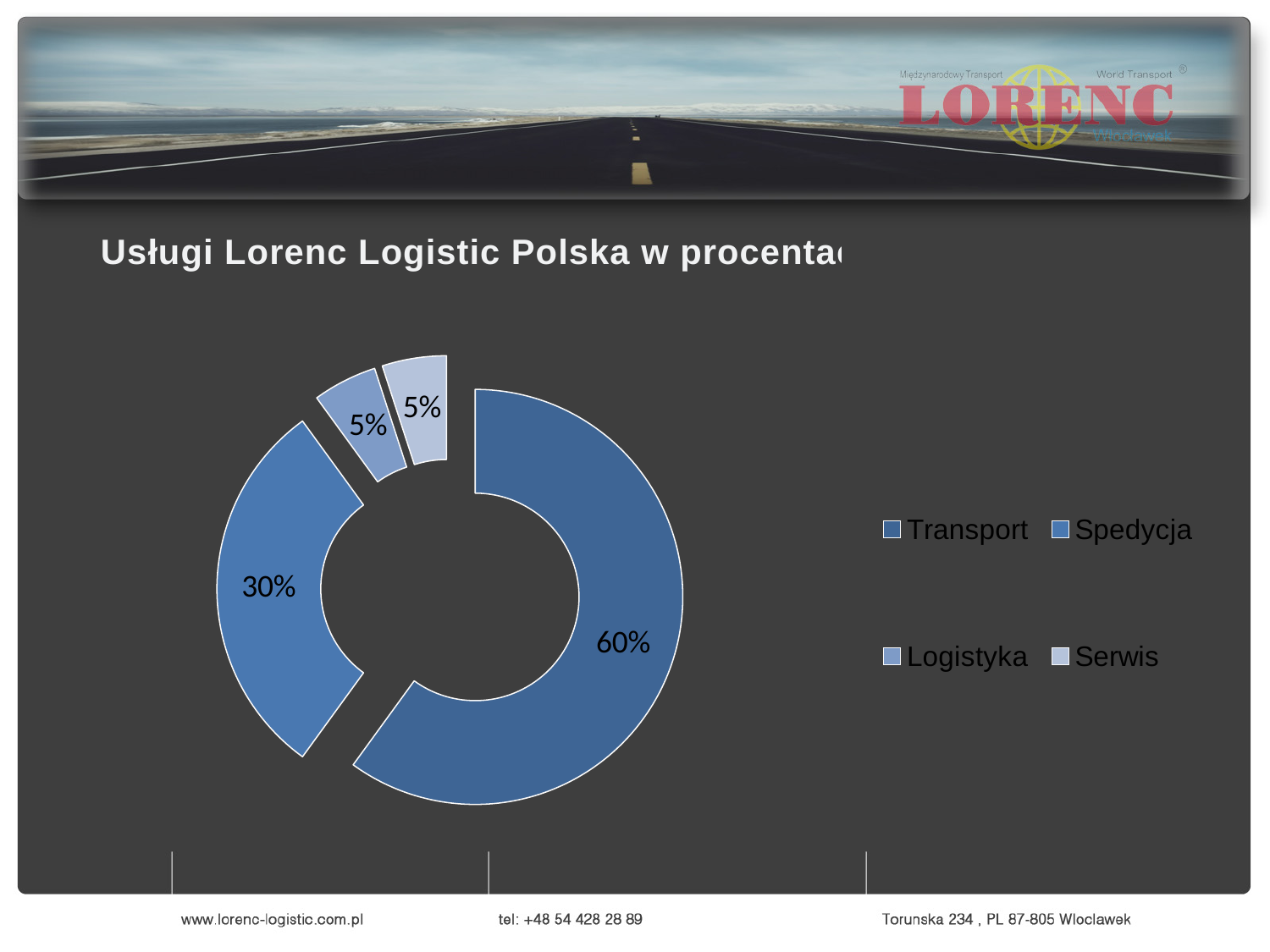
What percentage does Spedycja account for? 30% How many categories are shown in the chart? 4 How many entries does the legend list? 4 Which is larger, the share for Spedycja or the share for Logistyka? Spedycja What is the combined share of Logistyka and Serwis? 10% Which two categories share the smallest value in the chart? Logistyka and Serwis By how many percentage points does Transport exceed Spedycja? 30 What percentage of the chart is Transport? 60% What is the value shown for Logistyka? 5% What is the value shown for Serwis? 5% What type of chart is shown on the slide? Doughnut (pie) chart Which category has the largest share of the chart? Transport